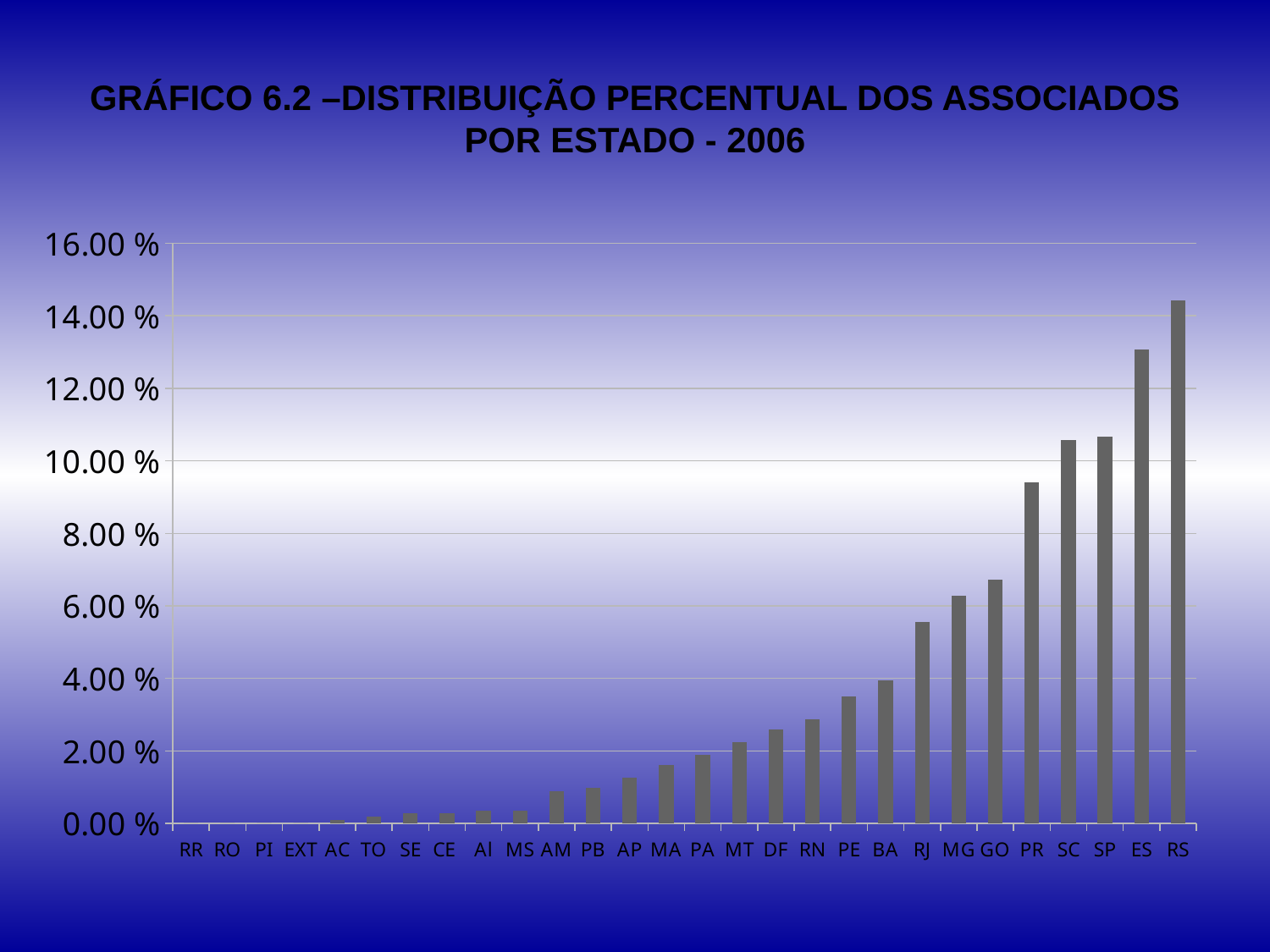
Which state has the highest percentage of associates? RS Is the value for ES greater or less than 14.00 %? less How many states/categories are shown on the x axis? 28 What year does the chart title refer to? 2006 Which has a larger value, RS or ES? RS Do the values rise or fall moving from left to right along the x axis? rise Is the value for PR greater or less than 10.00 %? less Is the value for MG greater or less than 6.00 %? greater What kind of chart is shown on the slide? bar chart